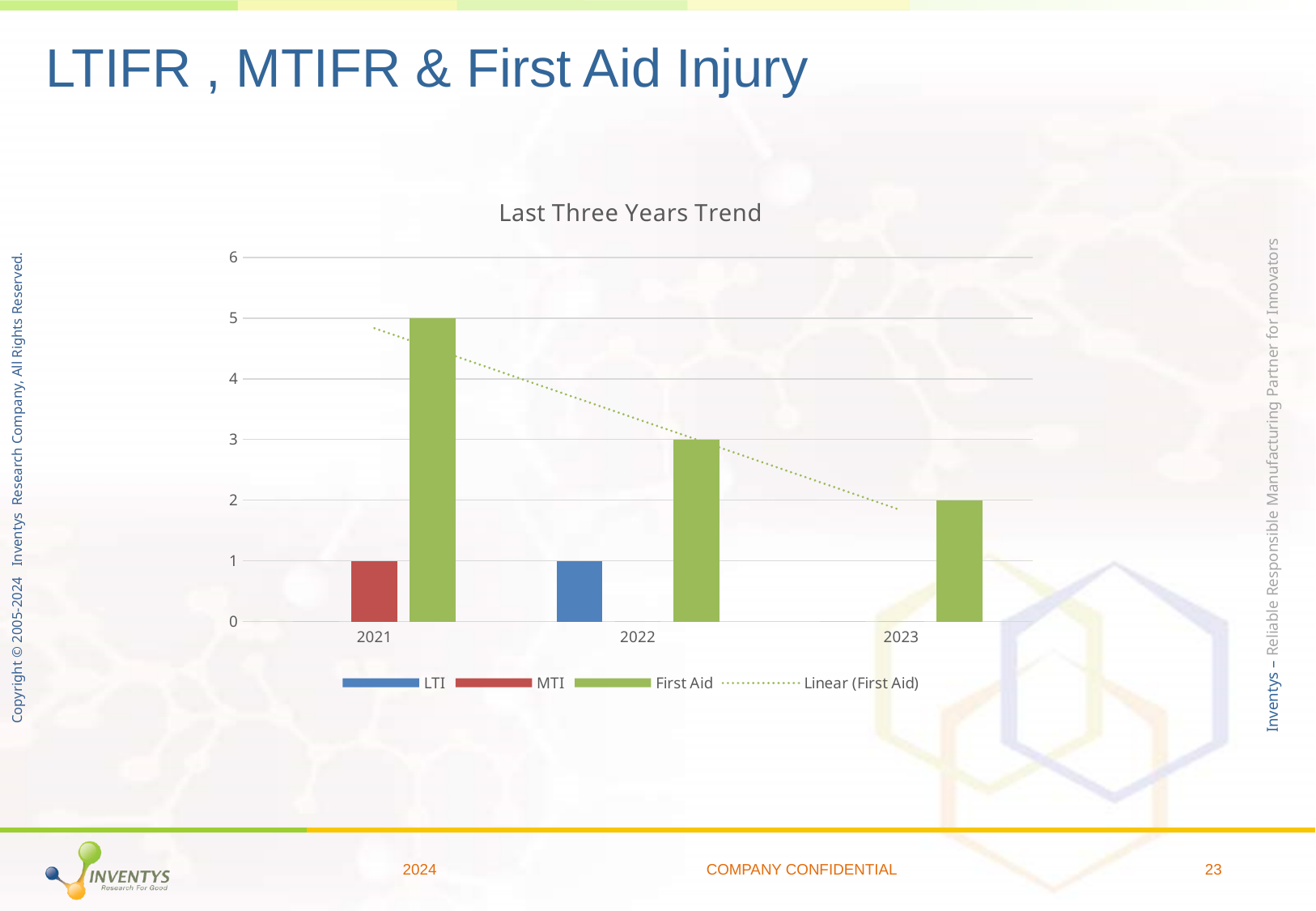
What is the difference between the First Aid values for 2021 and 2023? 3 What kind of chart is shown on the slide? bar chart What is the First Aid value for 2021? 5 Which year has the highest First Aid value? 2021 What is the First Aid value for 2022? 3 Which year has the lowest First Aid value? 2023 How many entries does the legend list? 4 What is the First Aid value for 2023? 2 What is the MTI value for 2021? 1 What is the title of the chart? Last Three Years Trend Do the First Aid values rise or fall from 2021 to 2023? fall What is the LTI value for 2022? 1